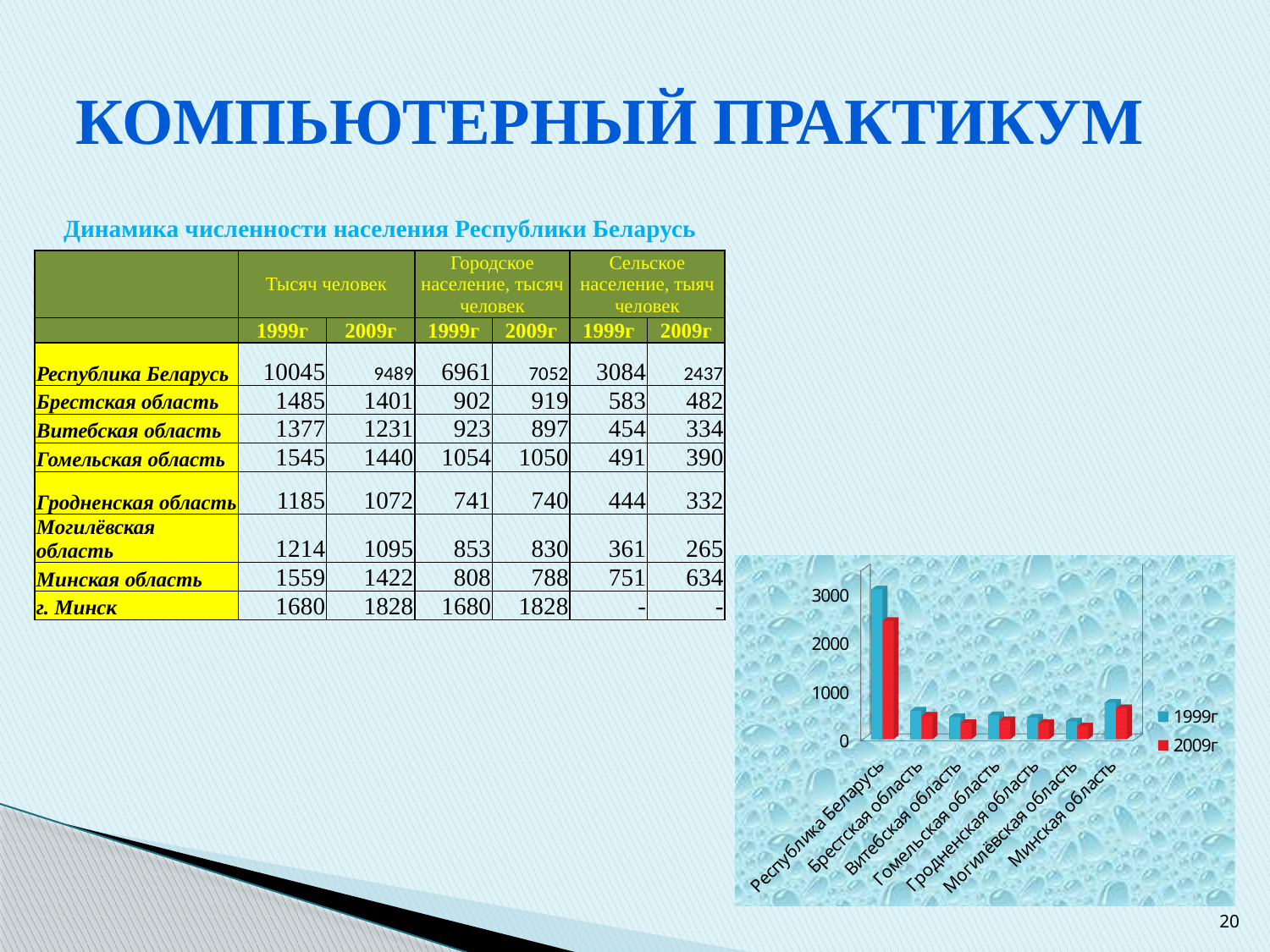
In the chart, which category has the larger 2009г bar: Минская область or Витебская область? Минская область What are the two series named in the chart legend? 1999г and 2009г What kind of chart is shown on the slide? bar chart Which category has the highest bars in the chart? Республика Беларусь What colour are the bars for the 2009г series in the chart? red How many categories are shown along the x axis of the chart? 7 Is the 1999г value for Минская область in the chart greater or less than 1000? less In the chart, which is larger for Республика Беларусь: the 1999г bar or the 2009г bar? 1999г In the chart, which category has the larger 1999г bar: Минская область or Брестская область? Минская область Is the 2009г value for Республика Беларусь in the chart greater or less than 2000? greater Is the 1999г value for Брестская область in the chart greater or less than 1000? less How many series does the chart legend list? 2